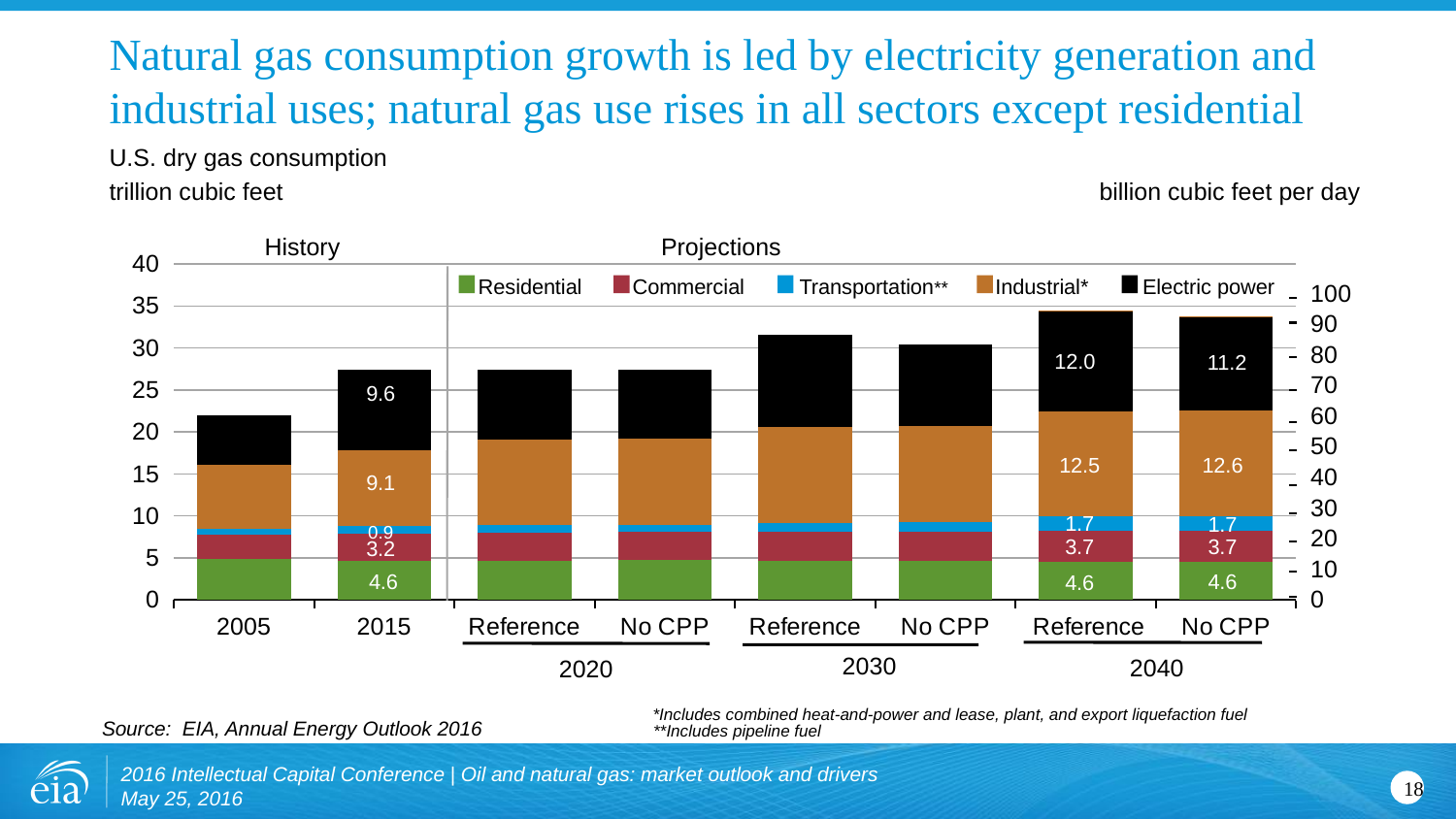
What is the Electric power value for 2015? 9.6 Which has the larger Industrial* value in 2040, Reference or No CPP? No CPP What kind of chart is shown on the slide? Stacked bar chart Which bar has the highest total consumption? 2040 Reference Is the total value for 2005 greater or less than 20 trillion cubic feet? greater What is the total of the stacked bar for 2015? 27.4 How many bars are shown in the chart? 8 How many series does the legend list? 5 Which bar has the lowest total consumption? 2005 What is the difference between the Electric power values for the 2040 Reference and 2040 No CPP cases? 0.8 What is the Transportation** value for the 2040 No CPP case? 1.7 What is the Industrial* value for the 2040 Reference case? 12.5